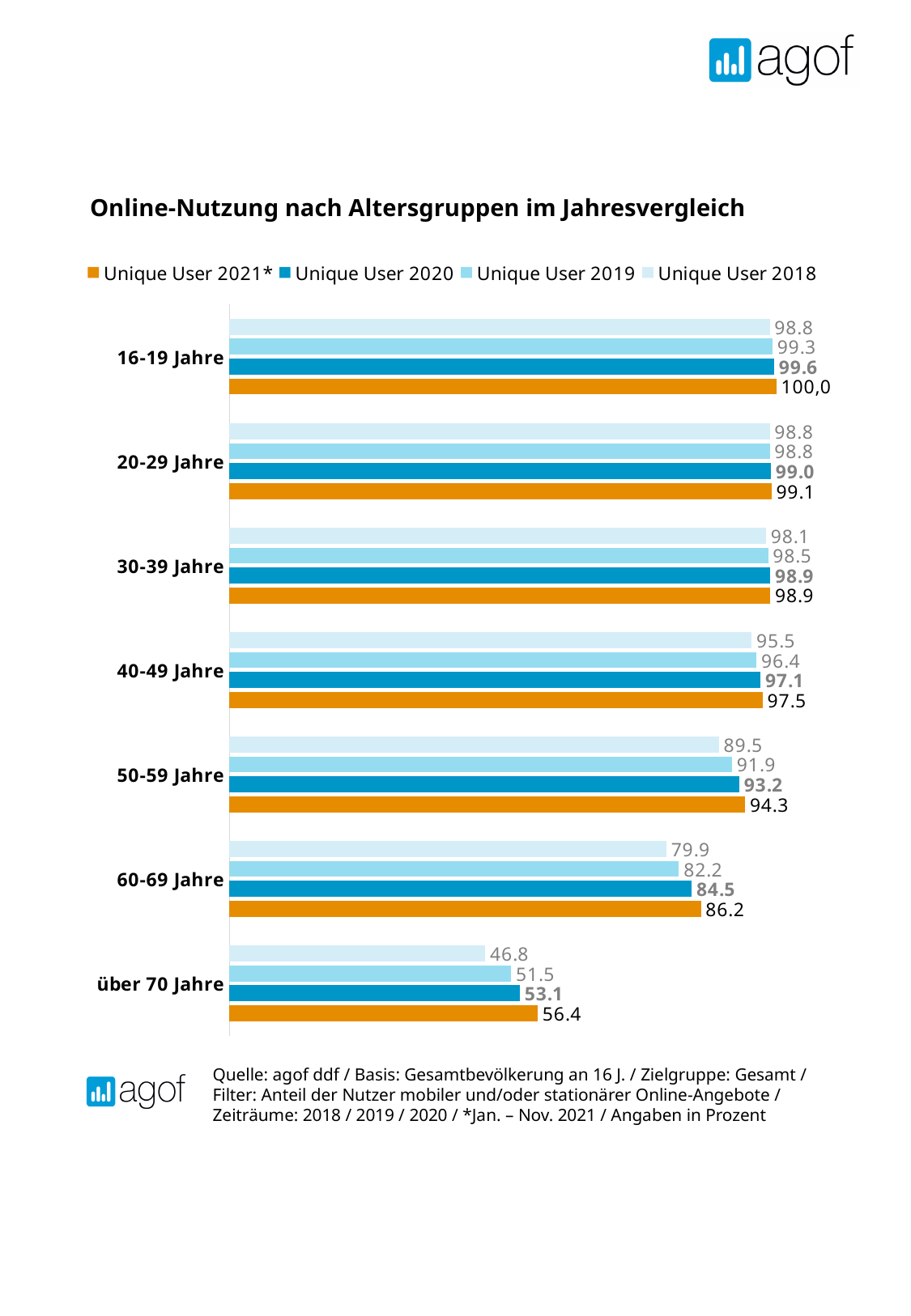
What is the Unique User 2019 value for the 40-49 Jahre age group? 96.4 What is the Unique User 2021* value for the 50-59 Jahre age group? 94.3 What is the difference between the Unique User 2021* and Unique User 2018 values for the über 70 Jahre age group? 9.6 What is the title of the chart? Online-Nutzung nach Altersgruppen im Jahresvergleich Which age group has the highest Unique User 2021* value? 16-19 Jahre What is the Unique User 2020 value for the 60-69 Jahre age group? 84.5 How many age groups are shown in the chart? 7 What is the Unique User 2018 value for the über 70 Jahre age group? 46.8 Which age group has the lowest Unique User 2018 value? über 70 Jahre What kind of chart is shown on the slide? Bar chart How many series does the legend list? 4 Which is larger for the 60-69 Jahre age group: the Unique User 2019 value or the Unique User 2020 value? Unique User 2020